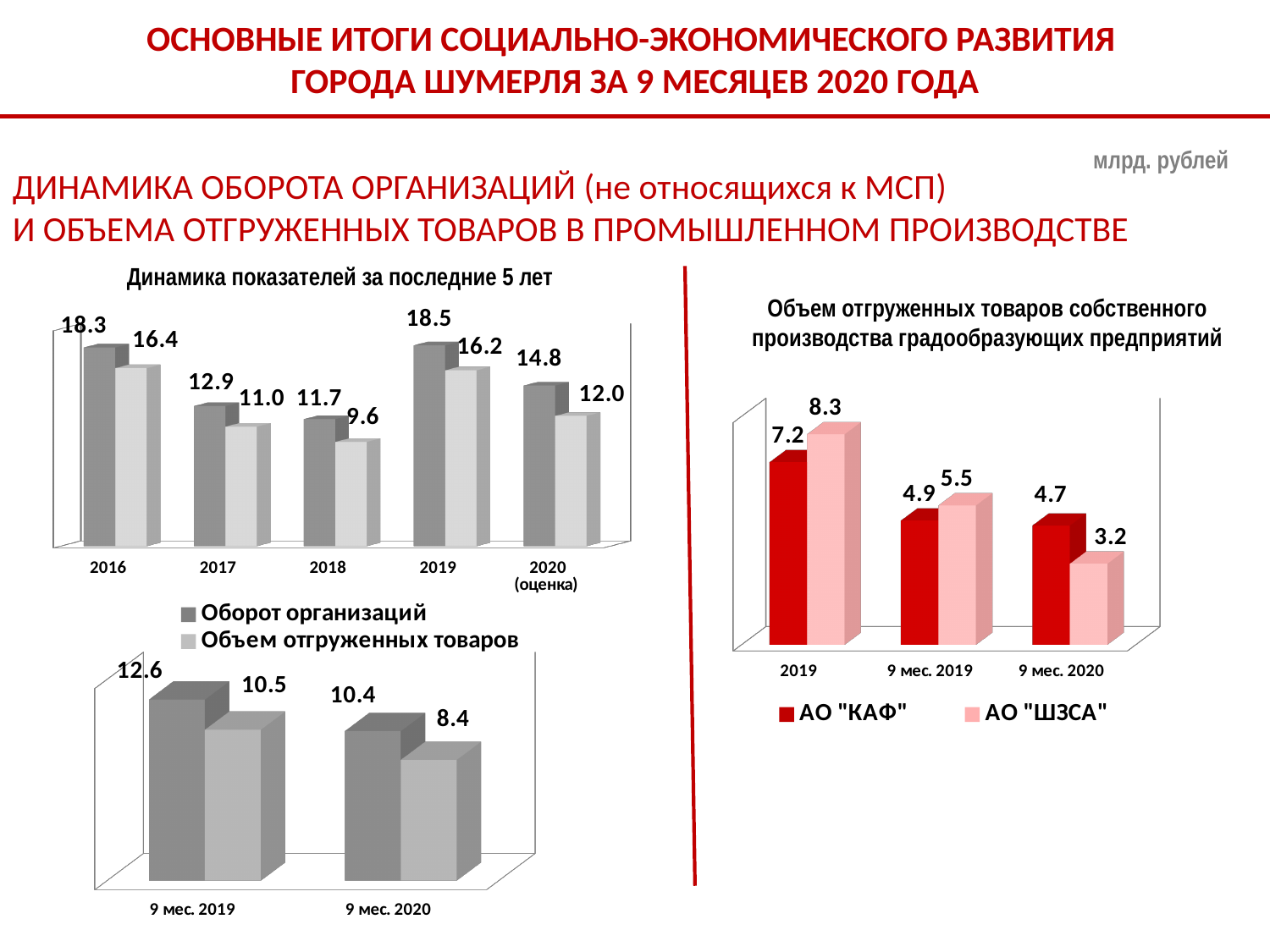
In the chart 'Объем отгруженных товаров собственного производства градообразующих предприятий', which is larger in 9 мес. 2019: АО "КАФ" or АО "ШЗСА"? АО "ШЗСА" In the chart 'Динамика показателей за последние 5 лет', what is the difference between 'Оборот организаций' and 'Объем отгруженных товаров' in 2020 (оценка)? 2.8 In the bottom-left chart comparing 9 мес. 2019 and 9 мес. 2020, what is the difference in 'Объем отгруженных товаров' between 9 мес. 2019 and 9 мес. 2020? 2.1 In the chart 'Динамика показателей за последние 5 лет', which year has the lowest value of 'Оборот организаций'? 2018 In the chart 'Динамика показателей за последние 5 лет', what is the value of 'Объем отгруженных товаров' for 2018? 9.6 In the chart 'Динамика показателей за последние 5 лет', how many years are shown on the x axis? 5 In the chart 'Объем отгруженных товаров собственного производства градообразующих предприятий', what is the value for АО "ШЗСА" in 9 мес. 2020? 3.2 In the chart 'Объем отгруженных товаров собственного производства градообразующих предприятий', what is the difference between АО "КАФ" and АО "ШЗСА" in 2019? 1.1 What type of chart is 'Объем отгруженных товаров собственного производства градообразующих предприятий'? Bar chart In the chart 'Динамика показателей за последние 5 лет', how many series does the legend list? 2 In the chart 'Динамика показателей за последние 5 лет', what is the value of 'Оборот организаций' for 2019? 18.5 In the bottom-left chart comparing 9 мес. 2019 and 9 мес. 2020, what is the value of 'Оборот организаций' for 9 мес. 2020? 10.4